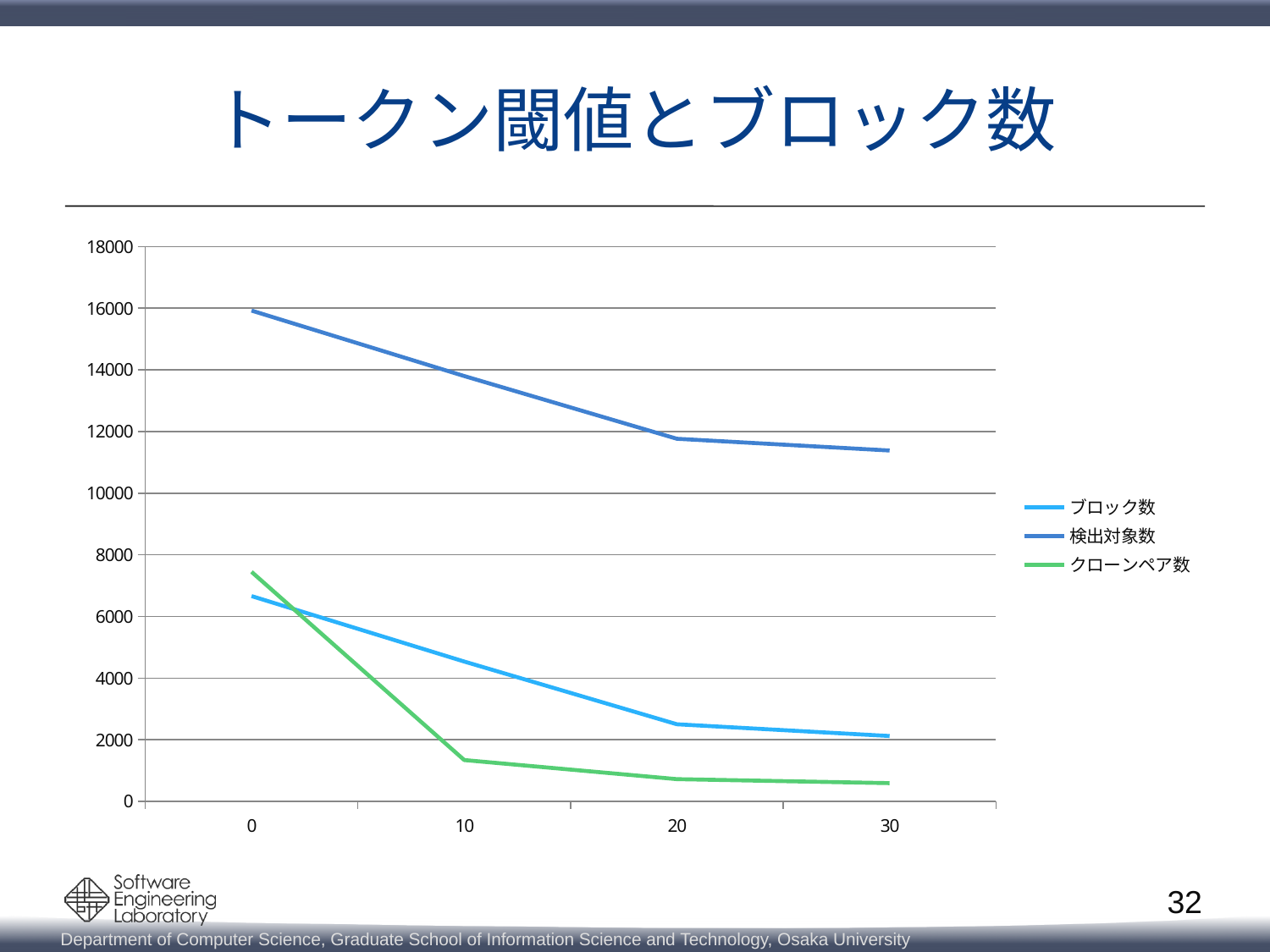
How many series does the legend list? 3 What kind of chart is shown on the slide? line chart Is the value of 検出対象数 at x = 30 greater or less than 12000? less Is the value of クローンペア数 at x = 10 greater or less than 2000? less Do the values of 検出対象数 rise or fall as x increases from 0 to 30? fall Which series has the highest value at x = 30? 検出対象数 At x = 10, which is larger: ブロック数 or クローンペア数? ブロック数 Is the value of ブロック数 at x = 0 greater or less than 6000? greater At x = 0, which is larger: ブロック数 or クローンペア数? クローンペア数 Which series has the lowest value at x = 20? クローンペア数 How many points are plotted along the x axis for each series? 4